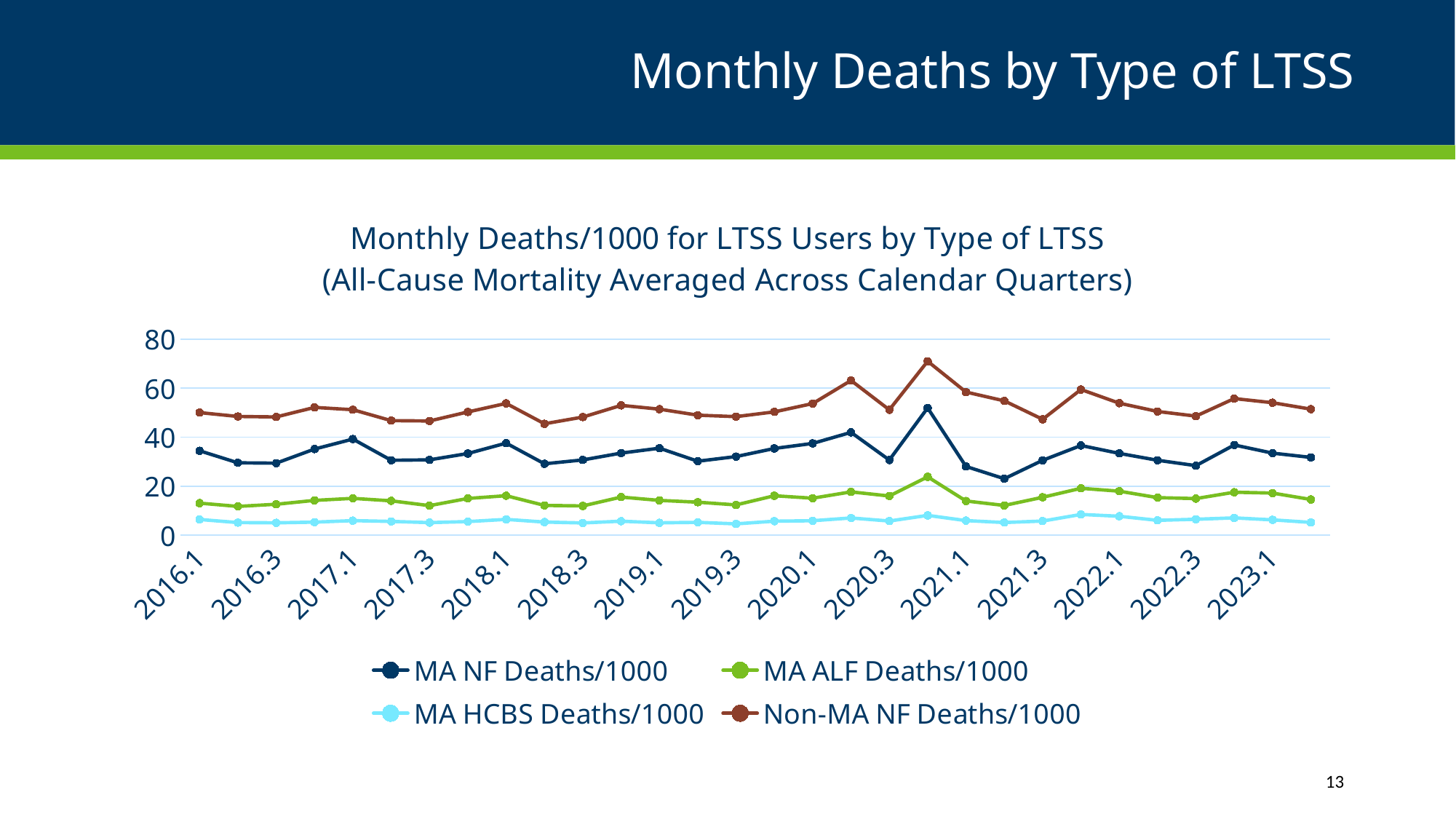
What kind of chart is shown on the slide? Line chart Is the value for Non-MA NF Deaths/1000 at 2016.1 greater or less than 40? greater Which series has the highest values across the whole period? Non-MA NF Deaths/1000 Which series has the lowest values across the whole period? MA HCBS Deaths/1000 Is the value for MA NF Deaths/1000 at 2021.3 greater or less than 40? less At 2017.1, which is larger: MA NF Deaths/1000 or MA ALF Deaths/1000? MA NF Deaths/1000 Is the peak value of Non-MA NF Deaths/1000 greater or less than 60? greater How many series does the legend list? 4 What is the first x-axis label shown on the chart? 2016.1 What is the second line of the chart title? (All-Cause Mortality Averaged Across Calendar Quarters)